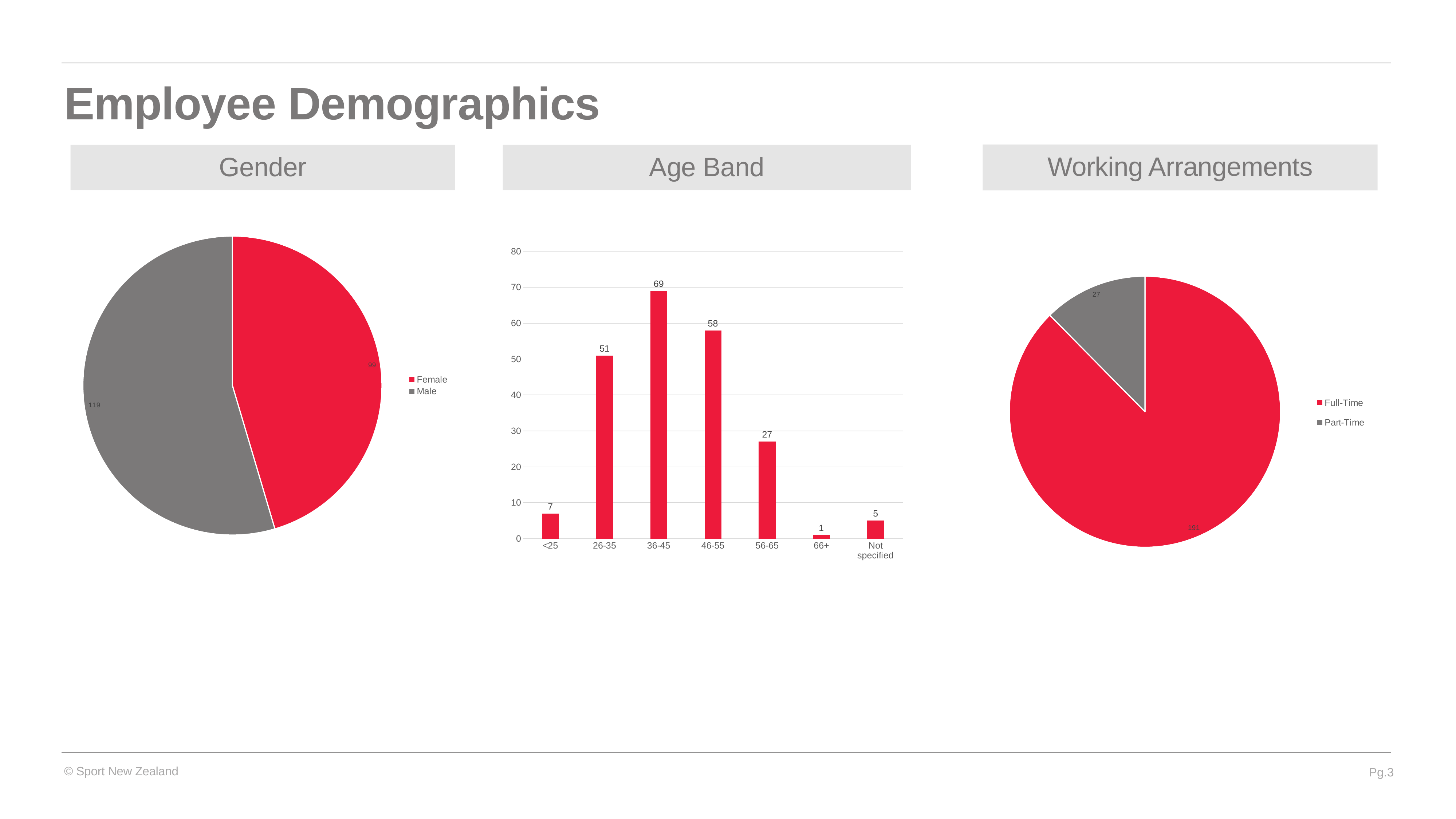
In the Age Band chart, what is the value for the 36-45 age band? 69 In the Gender chart, what is the value for Male? 119 How many series does the legend of the Working Arrangements chart list? 2 In the Age Band chart, which age band has the highest value? 36-45 In the Age Band chart, what is the value for the 56-65 age band? 27 In the Age Band chart, which age band has the lowest value? 66+ How many age bands are shown in the Age Band chart? 7 What kind of chart is the Age Band chart? Bar chart In the Age Band chart, which is larger, the value for 26-35 or the value for 46-55? 46-55 In the Working Arrangements chart, what is the value for Full-Time? 191 In the Age Band chart, what is the difference between the values for 36-45 and 46-55? 11 In the Gender chart, which is larger, Female or Male? Male